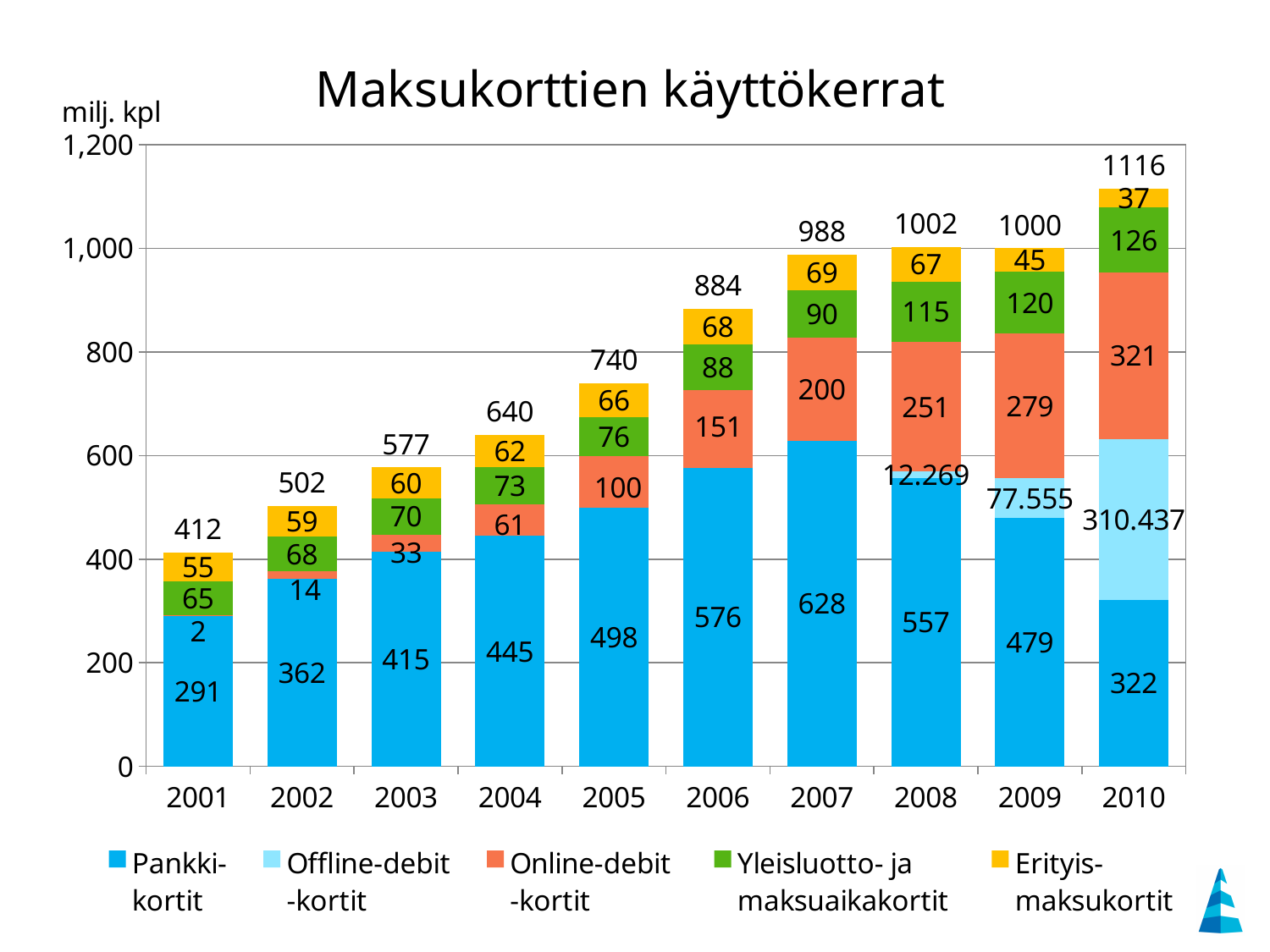
How many series does the legend list? 5 What is the value for Erityismaksukortit in 2001? 55 What is the value for Offline-debit-kortit in 2010? 310.437 What is the value for Pankkikortit in 2007? 628 How many years are shown on the x axis? 10 What kind of chart is shown on the slide? Stacked bar chart Which year has the lowest total? 2001 What is the value for Online-debit-kortit in 2009? 279 What is the total value shown above the bar for 2010? 1116 Which is larger, the Yleisluotto- ja maksuaikakortit value in 2008 or in 2009? 2009 What is the difference between the totals for 2010 and 2009? 116 Which year has the highest total? 2010